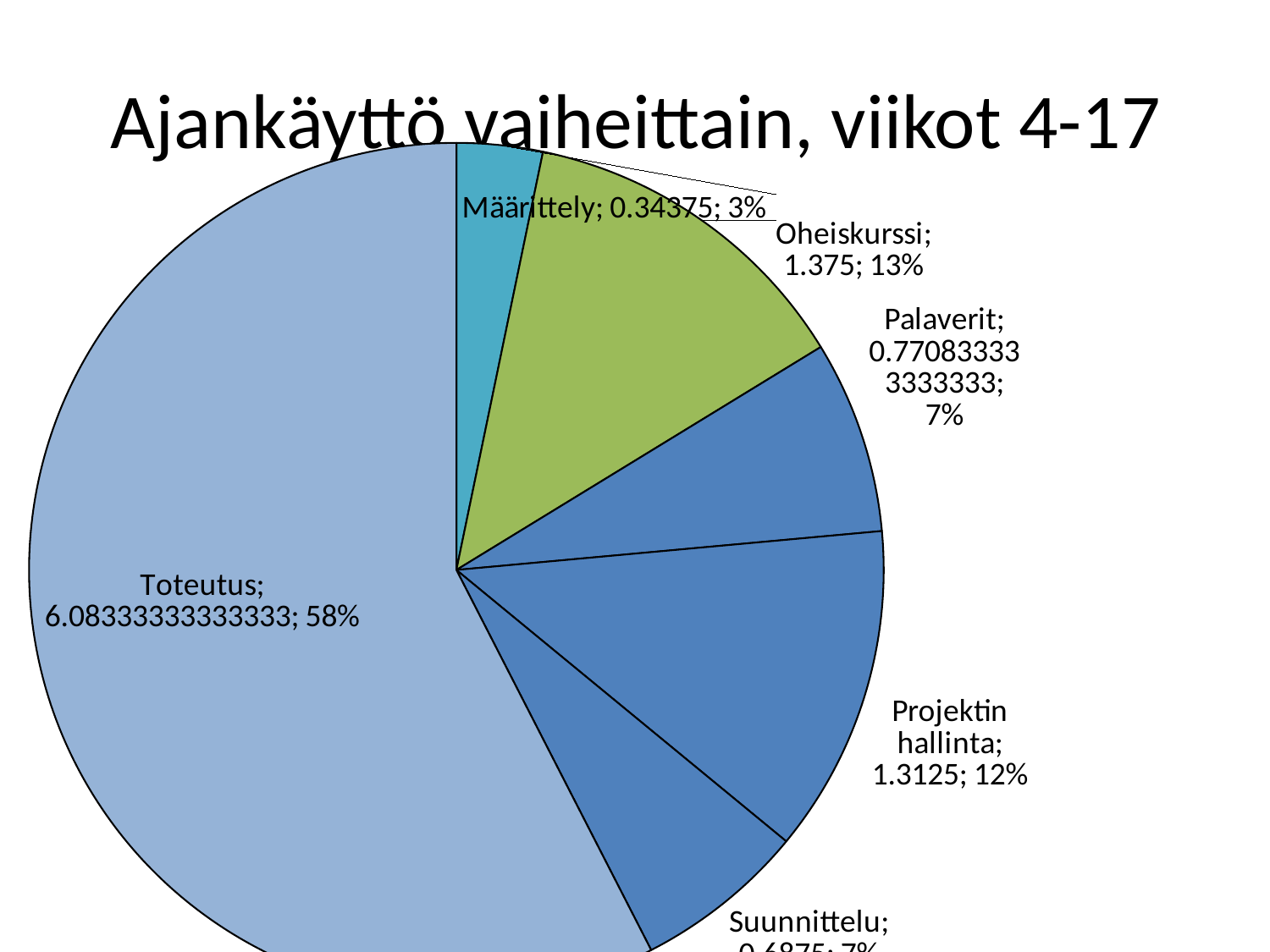
What is the title of the chart? Ajankäyttö vaiheittain, viikot 4-17 What is the value shown for Oheiskurssi? 1.375 What share of the pie does Palaverit take? 7% What is the value shown for Toteutus? 6.08333333333333 Which category has the largest slice? Toteutus How many slices does the pie chart have? 6 What kind of chart is shown on the slide? pie chart What is the value shown for Projektin hallinta? 1.3125 What share of the pie does Oheiskurssi take? 13% Which category has the smallest slice? Määrittely What is the value shown for Määrittely? 0.34375 What share of the pie does Toteutus take? 58%